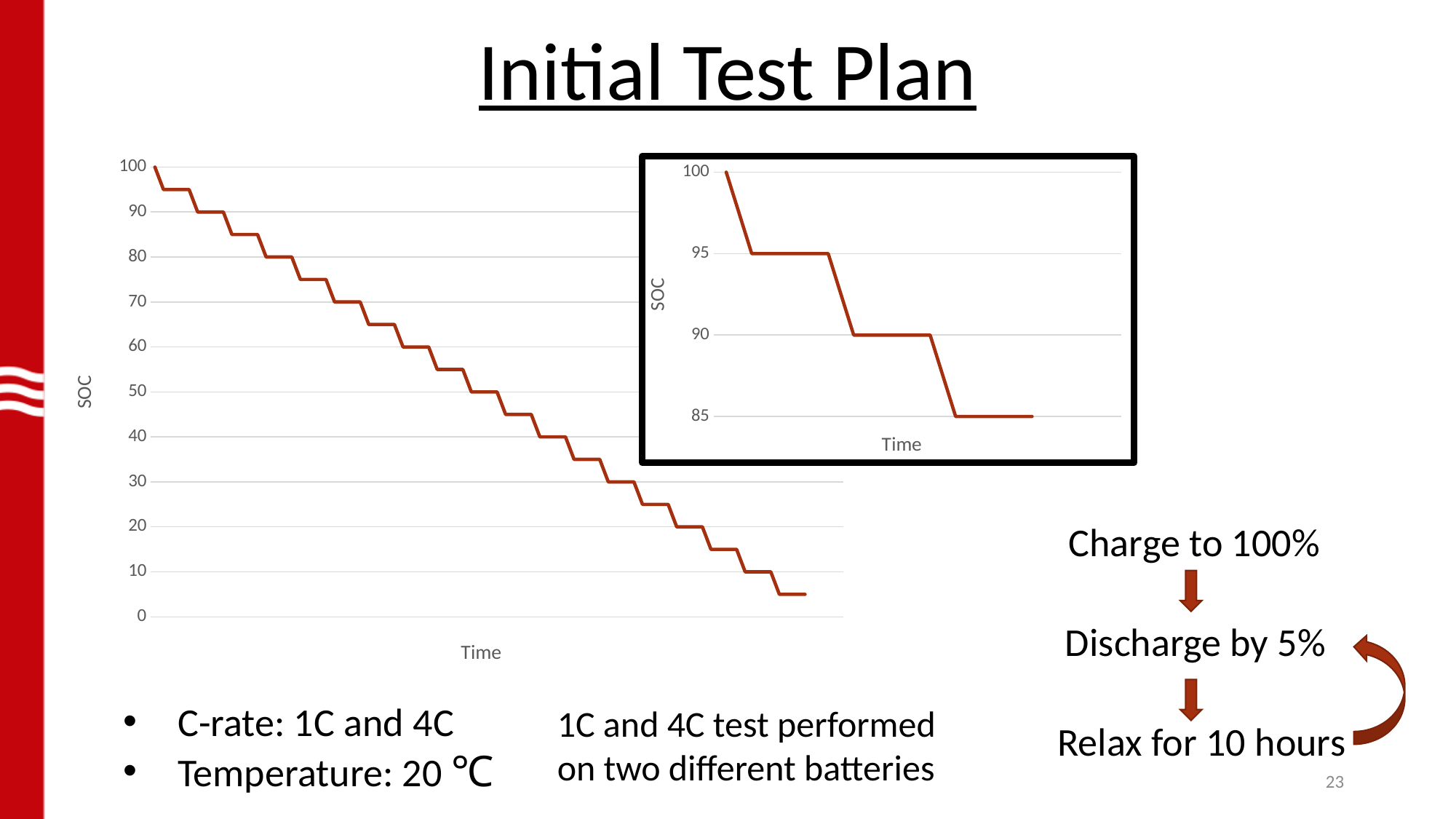
In the inset chart on the right, what is the SOC value at the start of the line? 100 What is the label on the vertical axis of the large chart on the left? SOC In the inset chart on the right, how many horizontal plateaus does the line have after the initial drop? 3 In the large chart on the left, is the SOC value at the end of the line greater or less than 0? greater What kind of chart is the large chart on the left of the slide? line chart In the inset chart on the right, what is the SOC value of the final plateau? 85 In the large chart on the left, what is the SOC value at the start of the line? 100 In the inset chart on the right, what is the difference between the starting SOC value and the final plateau value? 15 What is the label on the horizontal axis of the inset chart on the right? Time In the large chart on the left, is the SOC value at the end of the line greater or less than 10? less In the inset chart on the right, what is the lowest SOC value shown by the line? 85 In the large chart on the left, do the SOC values rise or fall along the time axis? fall